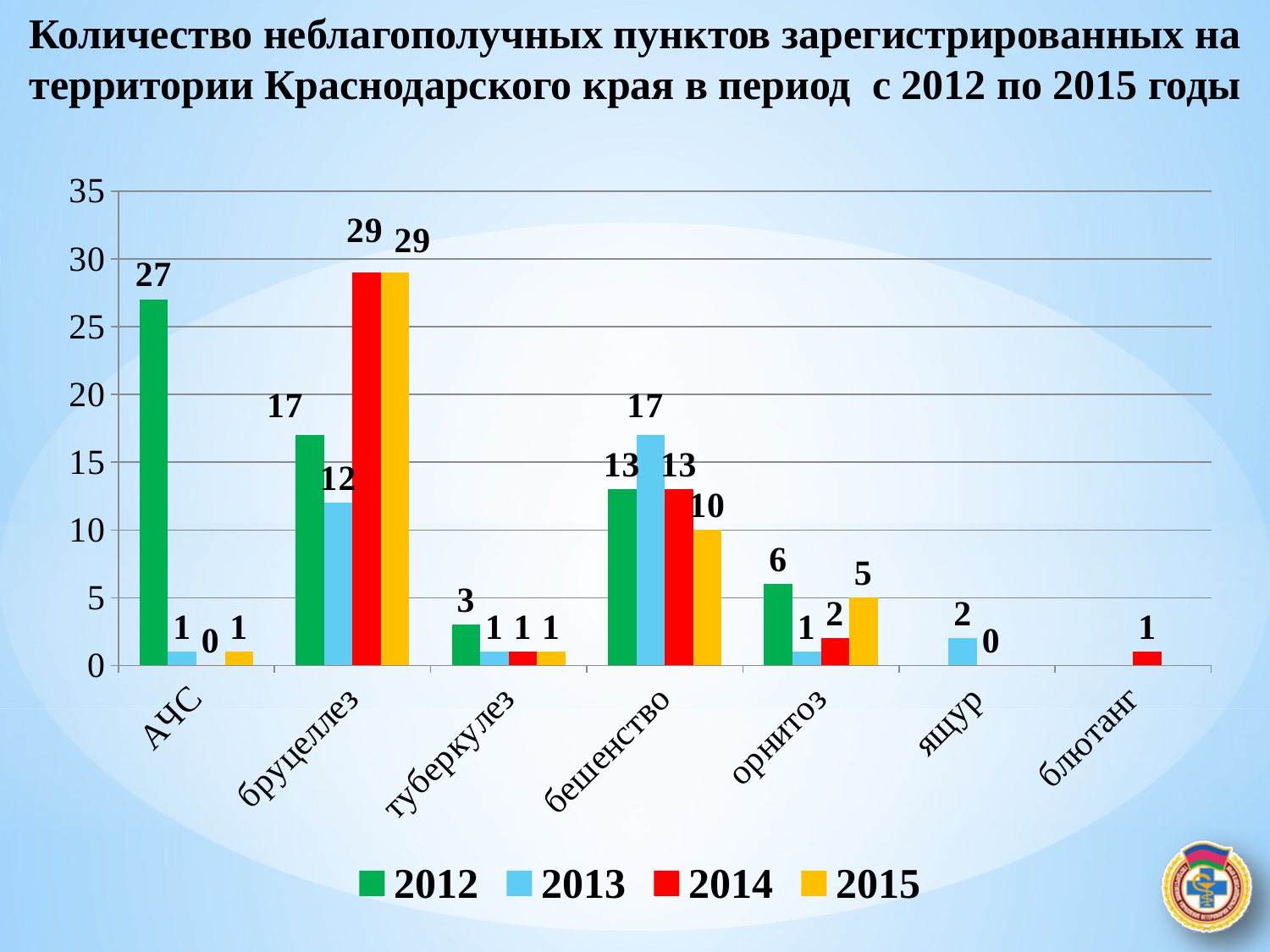
What is the value for орнитоз in 2015? 5 Which is larger: the 2012 value for бешенство or the 2015 value for бешенство? 2012 value for бешенство How many series does the legend list? 4 What is the value for АЧС in 2012? 27 What type of chart is shown on the slide? bar chart Which colour represents the 2014 series in the legend? red What is the difference between the 2012 and 2013 values for бруцеллез? 5 What is the value for бруцеллез in 2014? 29 How many categories are shown on the x axis? 7 Is the value for АЧС in 2012 greater or less than 25? greater What is the value for бешенство in 2013? 17 Which category has the highest value in 2012? АЧС